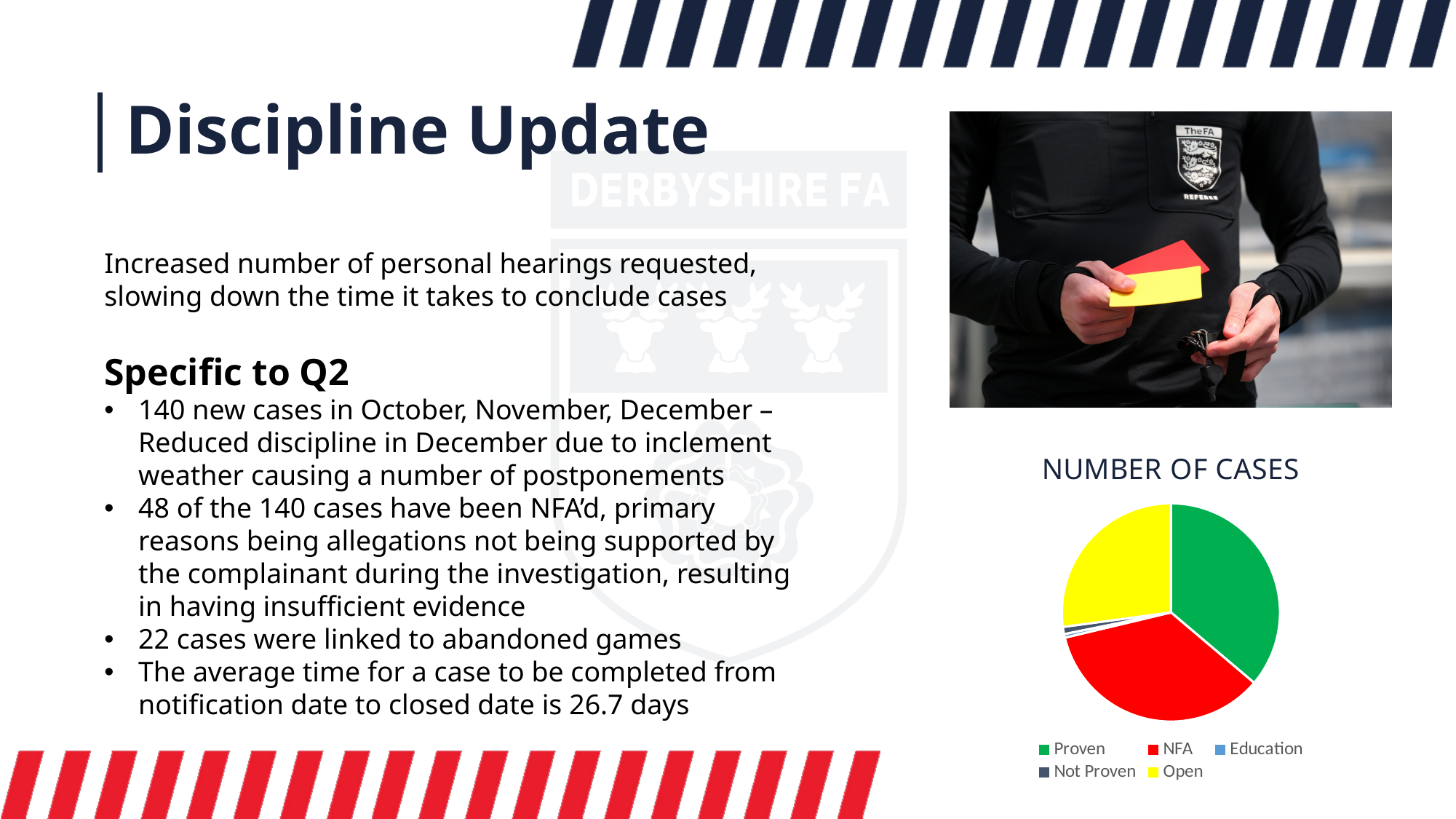
In the NUMBER OF CASES pie chart, which slice is larger, NFA or Open? NFA What kind of chart is shown under the title NUMBER OF CASES? pie chart In the NUMBER OF CASES pie chart, which slice is larger, Proven or Open? Proven In the NUMBER OF CASES pie chart, which slice is larger, Open or Education? Open What is the title of the pie chart on the slide? NUMBER OF CASES How many categories does the legend of the NUMBER OF CASES pie chart list? 5 Which colour represents the Open category in the NUMBER OF CASES pie chart? yellow Which category has the largest slice in the NUMBER OF CASES pie chart? Proven